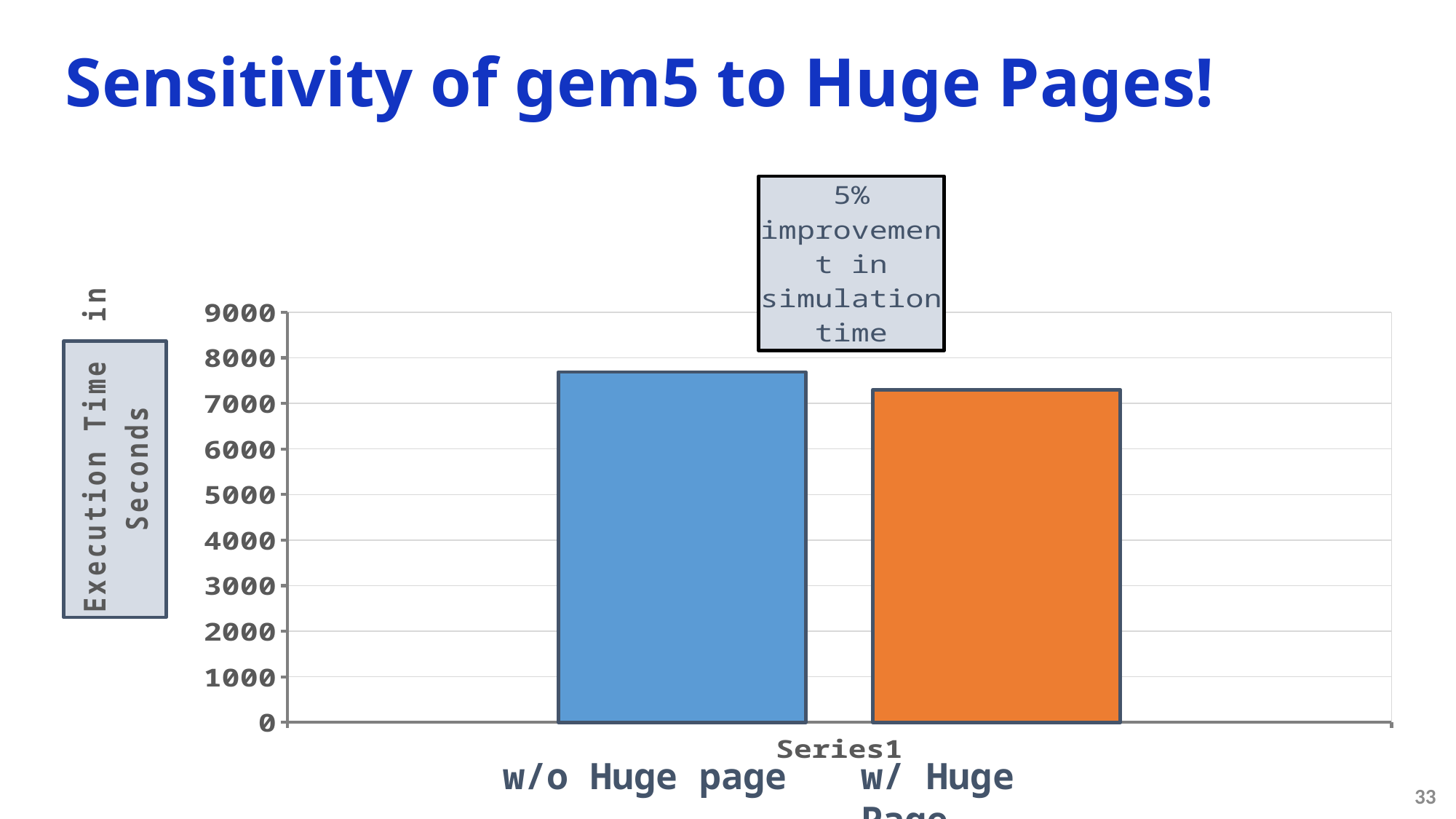
Is the execution time for w/ Huge Page larger or smaller than for w/o Huge page? smaller Is the value for w/o Huge page greater or less than 7000? greater What improvement in simulation time does the annotation box on the chart state? 5% improvement in simulation time How many bars are plotted in the chart? 2 Is the value for w/ Huge Page greater or less than 7000? greater Is the value for w/o Huge page greater or less than 8000? less What kind of chart is shown on the slide? bar chart What is the label of the vertical axis? Execution Time in Seconds Which bar has the higher execution time, w/o Huge page or w/ Huge Page? w/o Huge page Which bar has the lowest execution time? w/ Huge Page